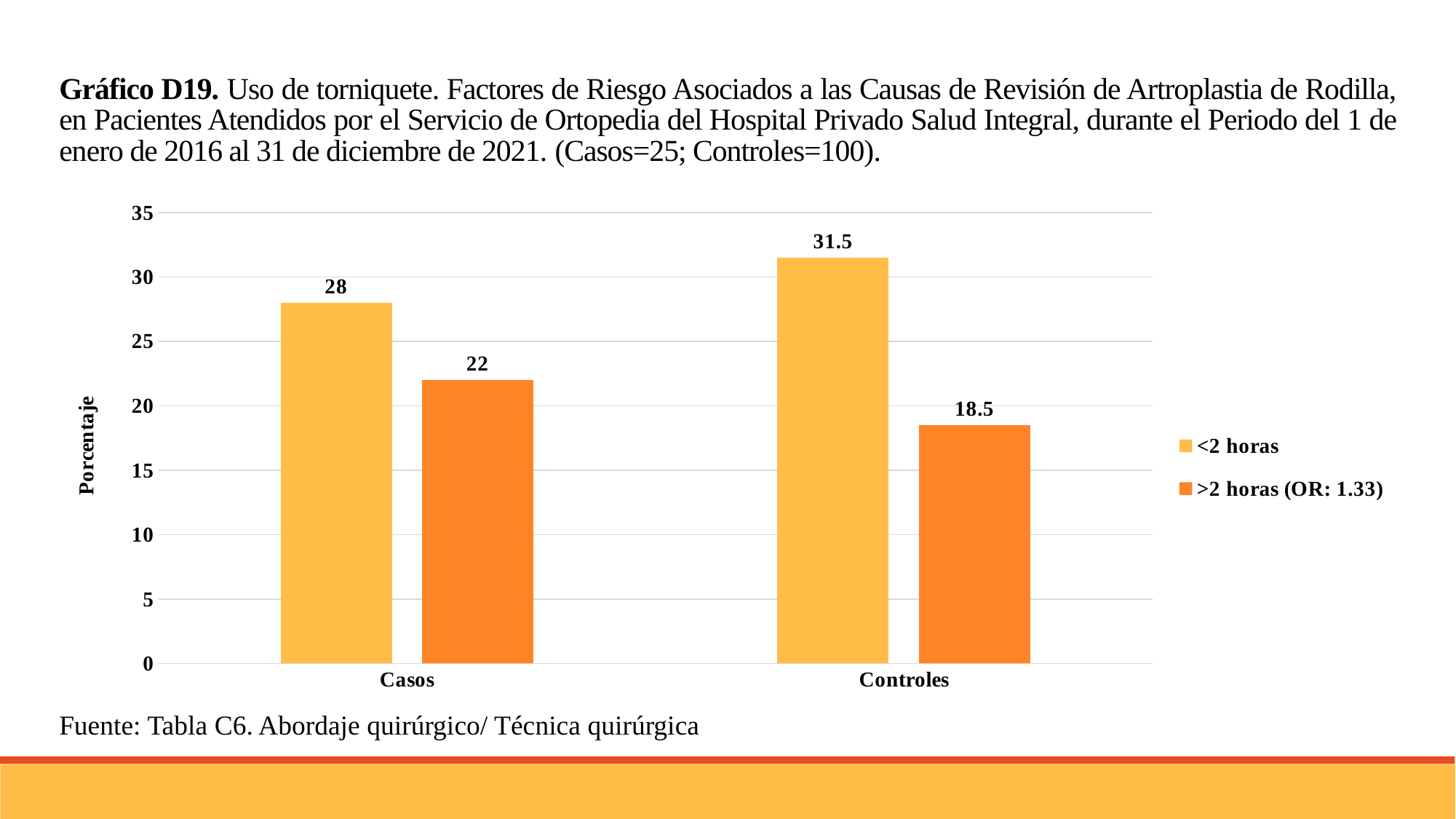
What is the value for '>2 horas (OR: 1.33)' in the Casos category? 22 What kind of chart is shown on the slide? Bar chart What is the difference between the '<2 horas' values for Controles and Casos? 3.5 How many series does the legend list? 2 What is the value for '>2 horas (OR: 1.33)' in the Controles category? 18.5 Which bar has the lowest value on the chart? >2 horas (OR: 1.33), Controles Which bar has the highest value on the chart? <2 horas, Controles How many categories are shown on the x axis? 2 What is the value for '<2 horas' in the Casos category? 28 What is the difference between the '<2 horas' and '>2 horas (OR: 1.33)' values in the Controles category? 13 Which is larger: the '>2 horas (OR: 1.33)' value for Casos or for Controles? Casos What is the value for '<2 horas' in the Controles category? 31.5